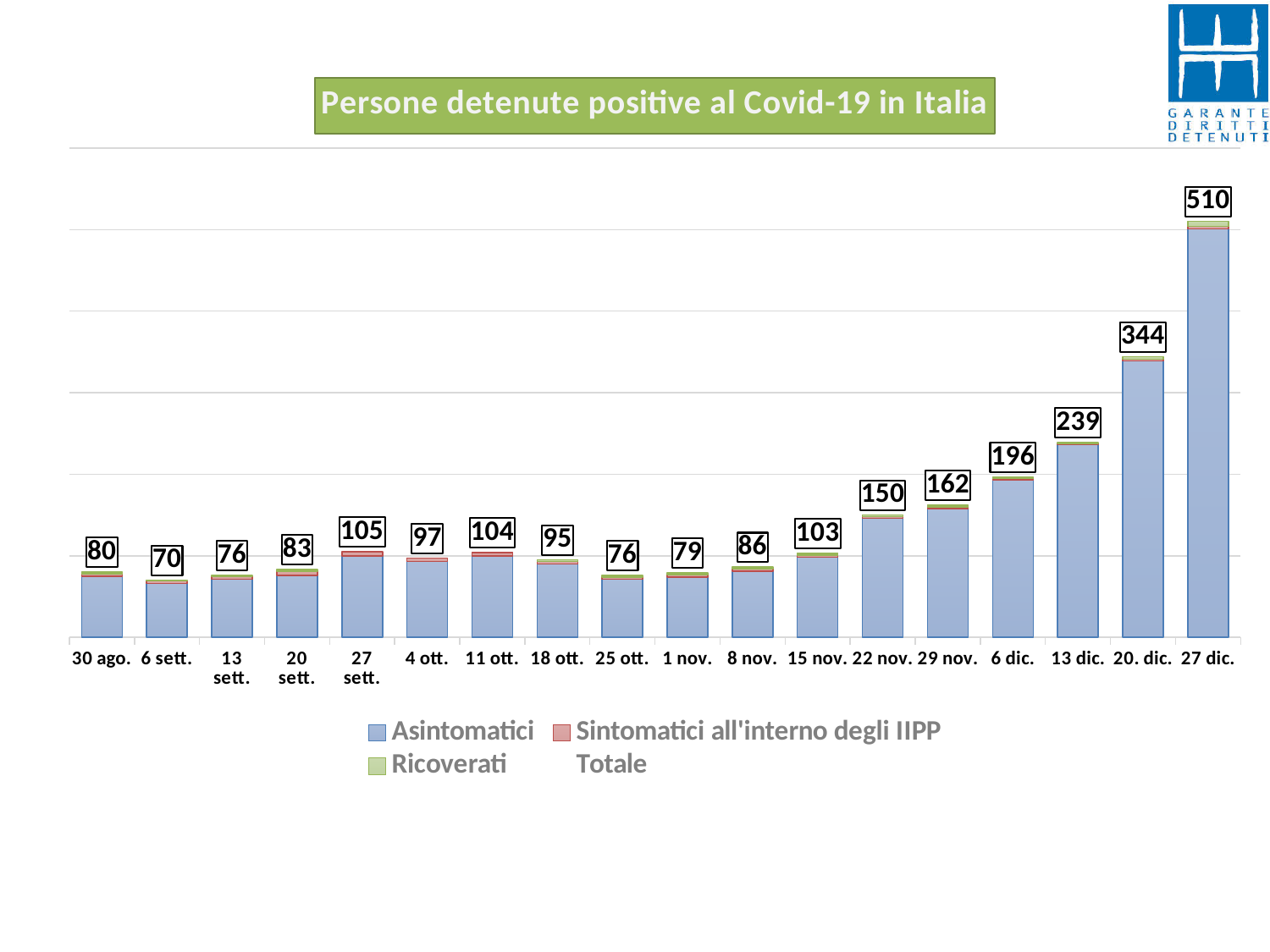
What is the difference between the totals for 13 dic. and 6 dic.? 43 How many dates are shown on the x axis? 18 What is the total value labelled for 22 nov.? 150 Which date has the lowest total? 6 sett. What kind of chart is shown on the slide? Stacked bar chart How many entries does the legend list? 4 Which date has the highest total? 27 dic. What is the total value labelled for 27 sett.? 105 Which is larger, the total for 11 ott. or the total for 18 ott.? 11 ott. Do the totals generally rise or fall from 8 nov. to 27 dic.? Rise What is the difference between the totals for 27 dic. and 20. dic.? 166 What is the total number of positive detainees shown for 27 dic.? 510